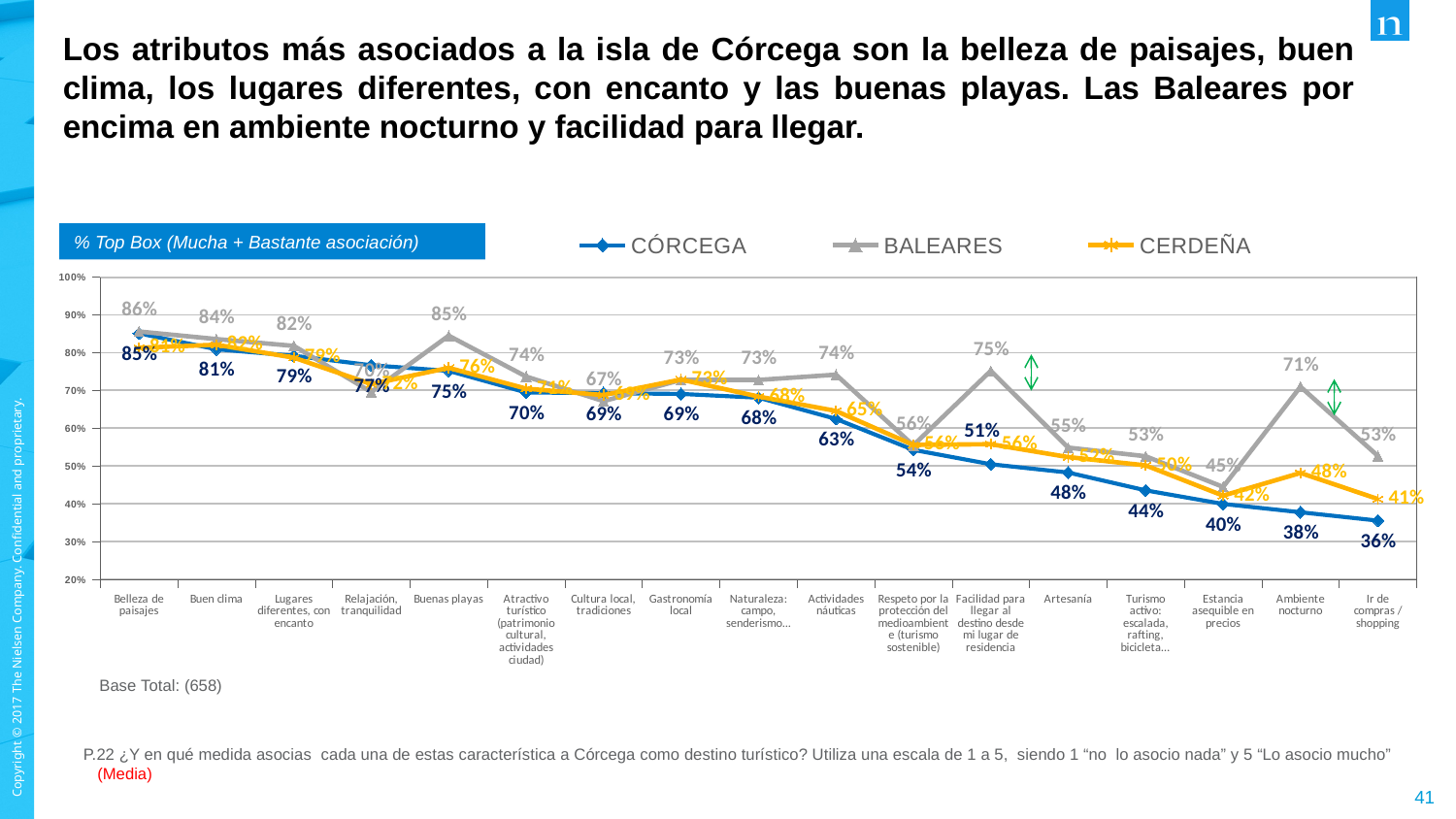
For which category does CÓRCEGA have its lowest value? Ir de compras / shopping For 'Facilidad para llegar al destino desde mi lugar de residencia', which is higher: BALEARES or CÓRCEGA? BALEARES Does the CÓRCEGA line generally rise or fall from left to right across the categories? Fall How many series does the chart legend list? 3 What is the value for CÓRCEGA for 'Belleza de paisajes'? 85% What is the value for CERDEÑA for 'Ir de compras / shopping'? 41% What type of chart is shown on the slide? Line chart How many attribute categories are plotted along the x axis? 17 What is the value for BALEARES for 'Ambiente nocturno'? 71% What is the difference between CÓRCEGA's value for 'Belleza de paisajes' and its value for 'Ir de compras / shopping'? 49 percentage points What is the value for CÓRCEGA for 'Ir de compras / shopping'? 36% For which category does CÓRCEGA have its highest value? Belleza de paisajes